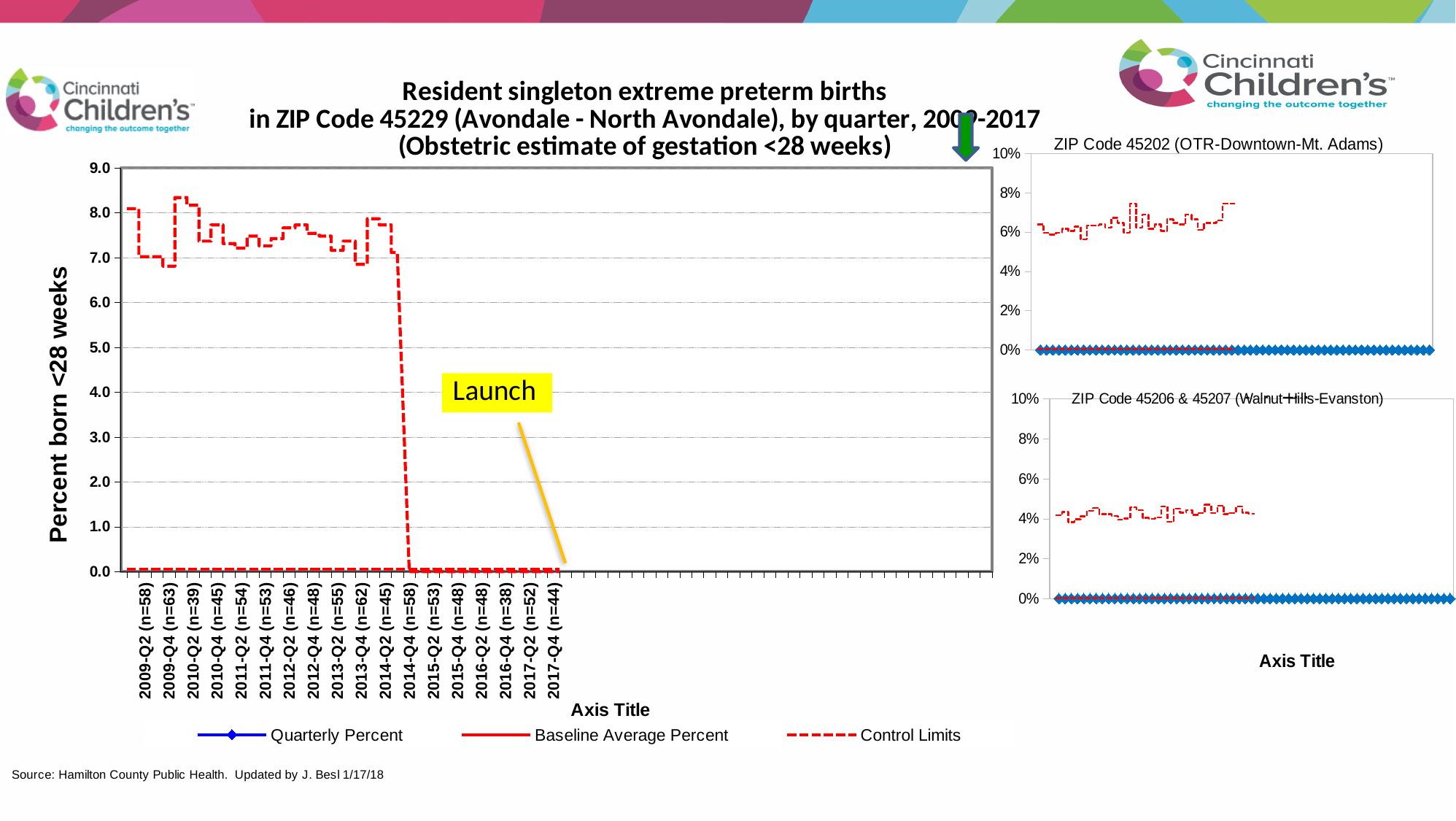
In the main ZIP Code 45229 chart, is the upper Control Limits value at 2014-Q2 (n=45) greater or less than 6.0? greater In the small chart titled 'ZIP Code 45206 & 45207 (Walnut Hills-Evanston)', is the blue Quarterly Percent series greater or less than 2% throughout? less In the main ZIP Code 45229 chart, which series is drawn with a dashed red line according to the legend? Control Limits In the main ZIP Code 45229 chart, what is the label of the vertical axis? Percent born <28 weeks In the small chart titled 'ZIP Code 45202 (OTR-Downtown-Mt. Adams)', is the upper dashed control limit line at its left end greater or less than 4%? greater How many series does the legend of the main ZIP Code 45229 chart list? 3 What kind of chart is the main chart titled 'Resident singleton extreme preterm births in ZIP Code 45229'? line chart In the main ZIP Code 45229 chart, does the upper Control Limits line rise or fall between 2014-Q2 (n=45) and 2015-Q2 (n=53)? fall